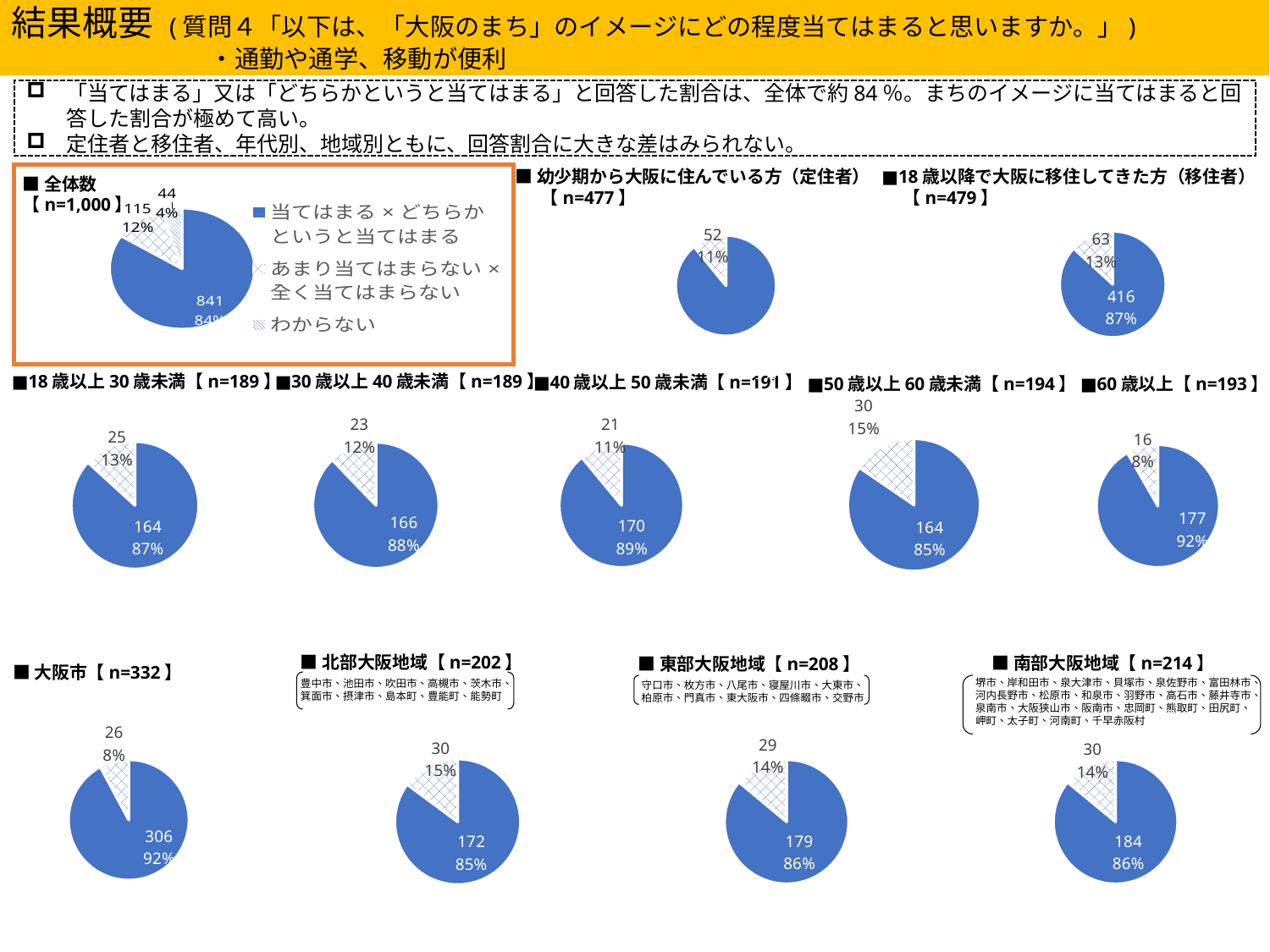
「大阪市【n=332】」の円グラフで、最も大きい区分の回答数と網掛けの区分の回答数の差はいくつですか。 280 「全体数【n=1,000】」の円グラフの凡例には、いくつの項目がありますか。 3 「40歳以上50歳未満【n=191】」の円グラフで、最も大きい区分の回答数はいくつですか。 170 「南部大阪地域【n=214】」の円グラフで、最も大きい区分の回答数はいくつですか。 184 「60歳以上【n=193】」の円グラフで、最も大きい区分の割合は何%ですか。 92% 「18歳以降で大阪に移住してきた方（移住者）【n=479】」の円グラフで、最も大きい区分の回答数はいくつですか。 416 「全体数【n=1,000】」の円グラフで、「わからない」の回答数はいくつですか。 44 「全体数【n=1,000】」の円グラフで、「当てはまる×どちらかというと当てはまる」の割合は何%ですか。 84% 「50歳以上60歳未満【n=194】」の円グラフで、網掛けの区分の回答数はいくつですか。 30 「北部大阪地域【n=202】」と「東部大阪地域【n=208】」の円グラフで、最も大きい区分の割合が高いのはどちらですか。 東部大阪地域 「幼少期から大阪に住んでいる方（定住者）【n=477】」の円グラフで、網掛けの区分の割合は何%ですか。 11% このスライドのグラフはどの種類のグラフですか。 円グラフ